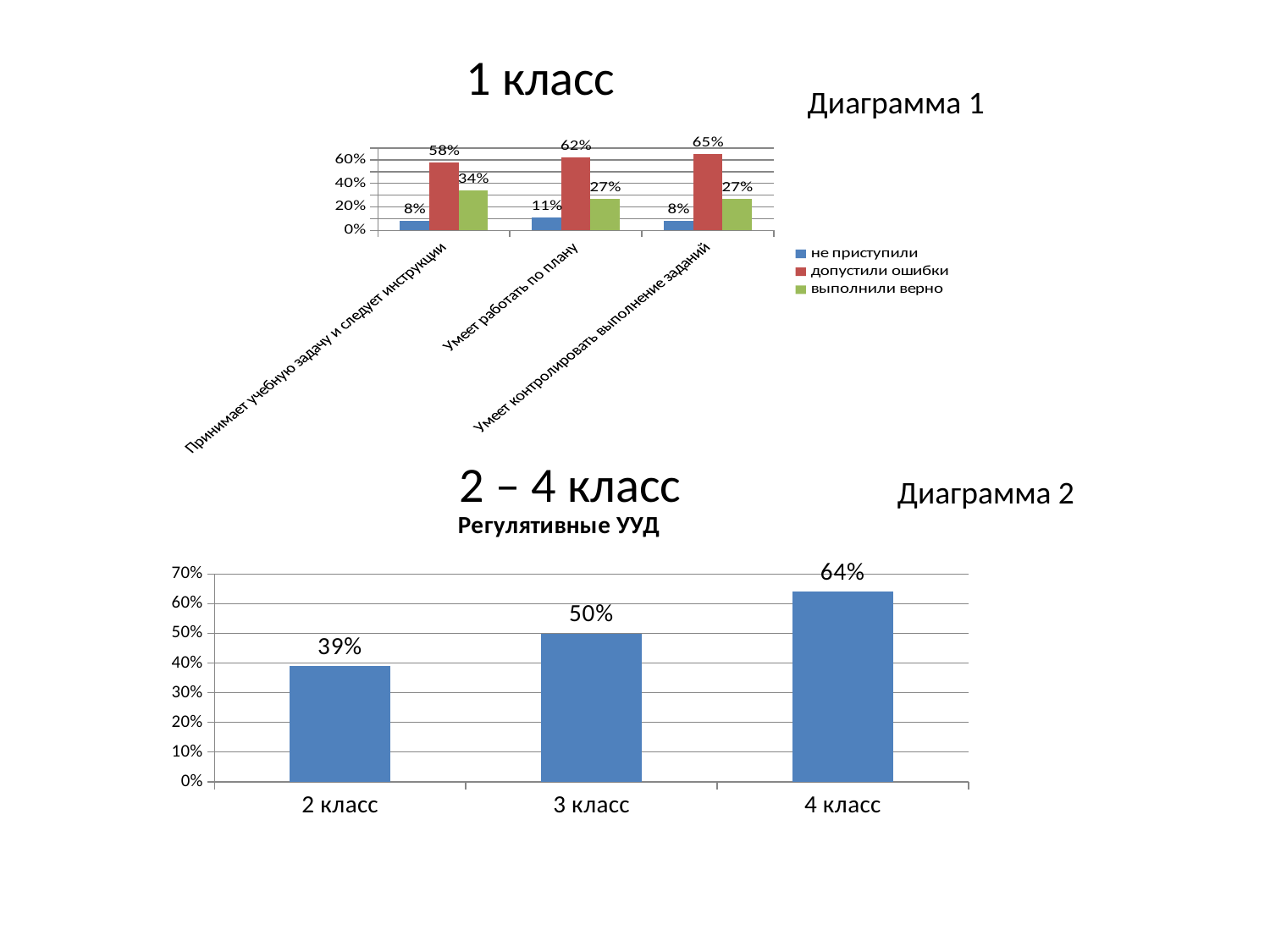
In the top chart (Диаграмма 1), which category has the highest value for 'допустили ошибки'? Умеет контролировать выполнение заданий In the bottom chart (Регулятивные УУД), do the values rise or fall from '2 класс' to '4 класс'? rise In the top chart (Диаграмма 1), how many series does the legend list? 3 In the bottom chart (Регулятивные УУД), what is the value for '3 класс'? 50% In the top chart (Диаграмма 1), what is the value of 'не приступили' for 'Умеет контролировать выполнение заданий'? 8% In the bottom chart (Регулятивные УУД), what is the difference between '4 класс' and '2 класс'? 25% In the bottom chart (Регулятивные УУД), which category has the lowest value? 2 класс In the top chart (Диаграмма 1), what is the difference between 'допустили ошибки' and 'выполнили верно' for 'Умеет работать по плану'? 35% In the top chart (Диаграмма 1), what is the value of 'допустили ошибки' for 'Умеет работать по плану'? 62% In the top chart (Диаграмма 1), what is the value of 'выполнили верно' for 'Принимает учебную задачу и следует инструкции'? 34% What kind of chart is the bottom chart (Регулятивные УУД)? bar chart In the bottom chart (Регулятивные УУД), how many categories are shown? 3